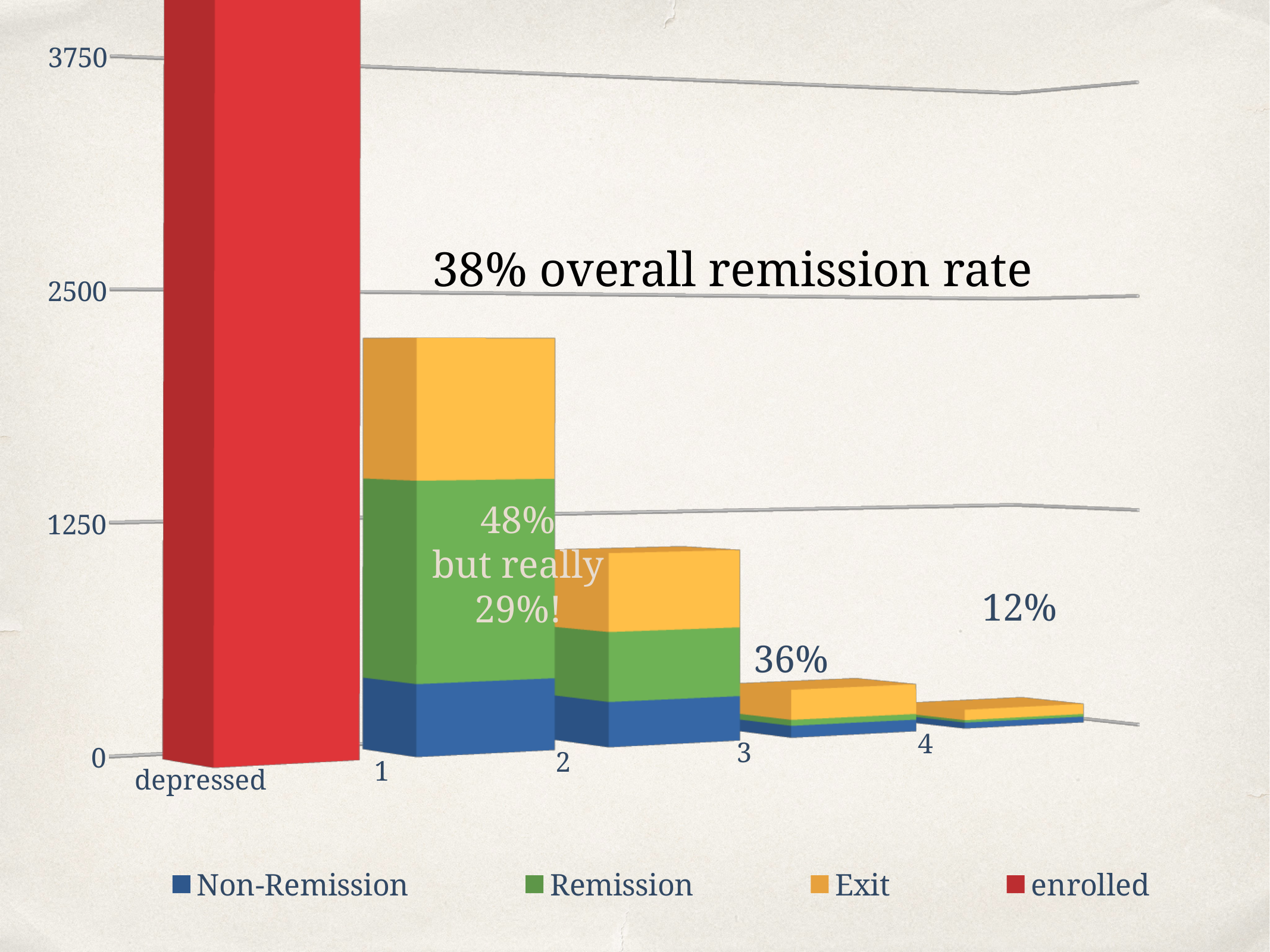
What overall remission rate is stated in the text on the chart? 38% Do the stacked bars rise or fall from category 1 to category 4? fall Which category has the shortest bar? 4 Which series is shown in red in the legend? enrolled Is the total height of the bar for category 3 greater or less than 1250? less How many series does the legend list? 4 What kind of chart is shown on the slide? bar chart Which category has the tallest bar? depressed Which bar is taller, category 1 or category 2? category 1 Is the total height of the bar for category 1 greater or less than 2500? less Is the value for the depressed bar greater or less than 3750? greater How many categories are shown along the x axis? 5